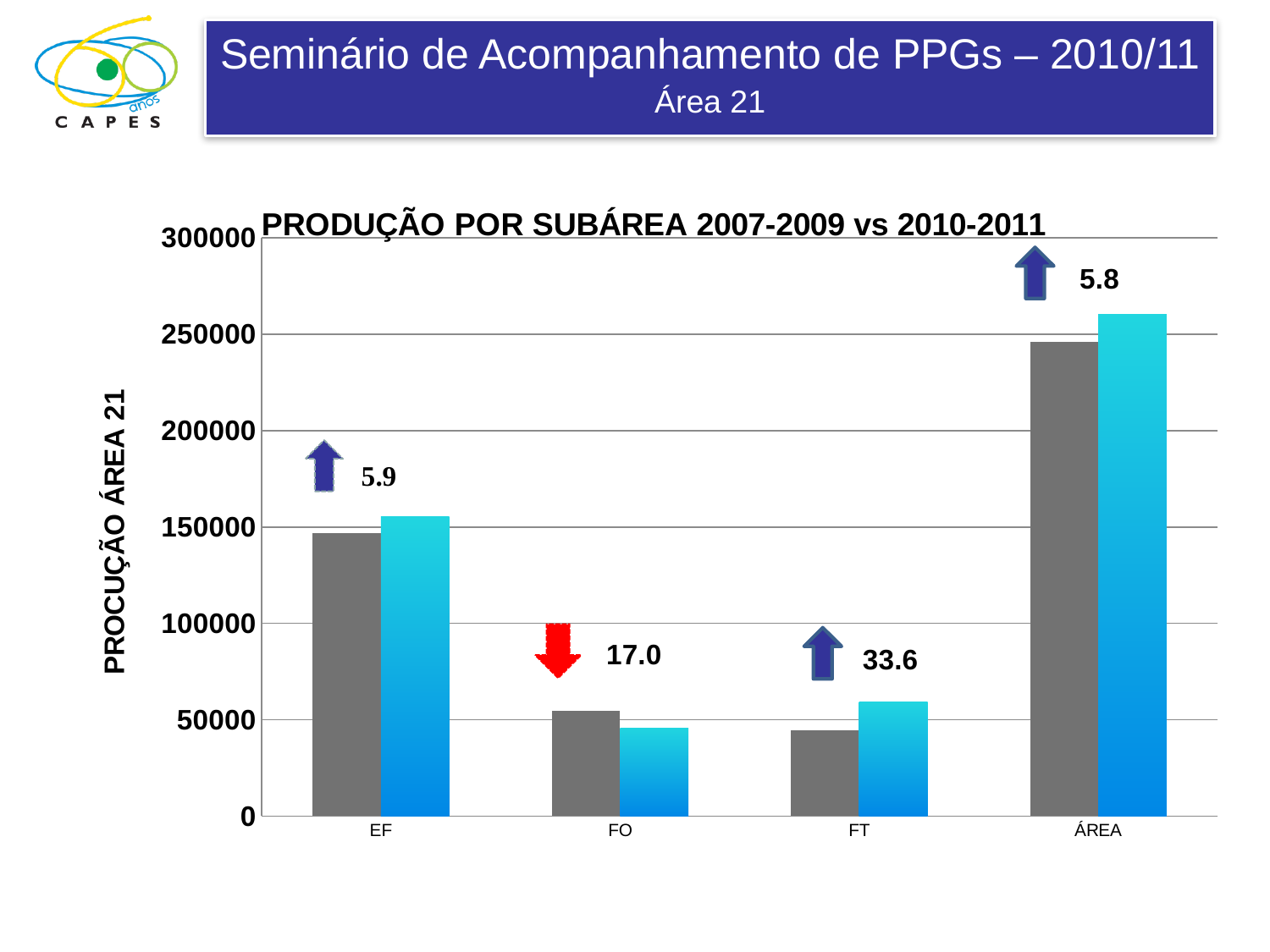
For FT, which bar is larger, the gray bar or the blue bar? the blue bar What kind of chart is shown on the slide? bar chart Is the value of the blue bar for EF greater or less than 150000? greater What percentage figure is printed next to the arrow above FO? 17.0 Which category has the tallest bars in the chart? ÁREA Is the value of the blue bar for FT greater or less than 50000? greater Is the value of the blue bar for ÁREA greater or less than 250000? greater What is the title of the chart? PRODUÇÃO POR SUBÁREA 2007-2009 vs 2010-2011 What percentage figure is printed next to the arrow above FT? 33.6 How many categories are shown on the x axis of the chart? 4 For FO, which bar is larger, the gray bar or the blue bar? the gray bar